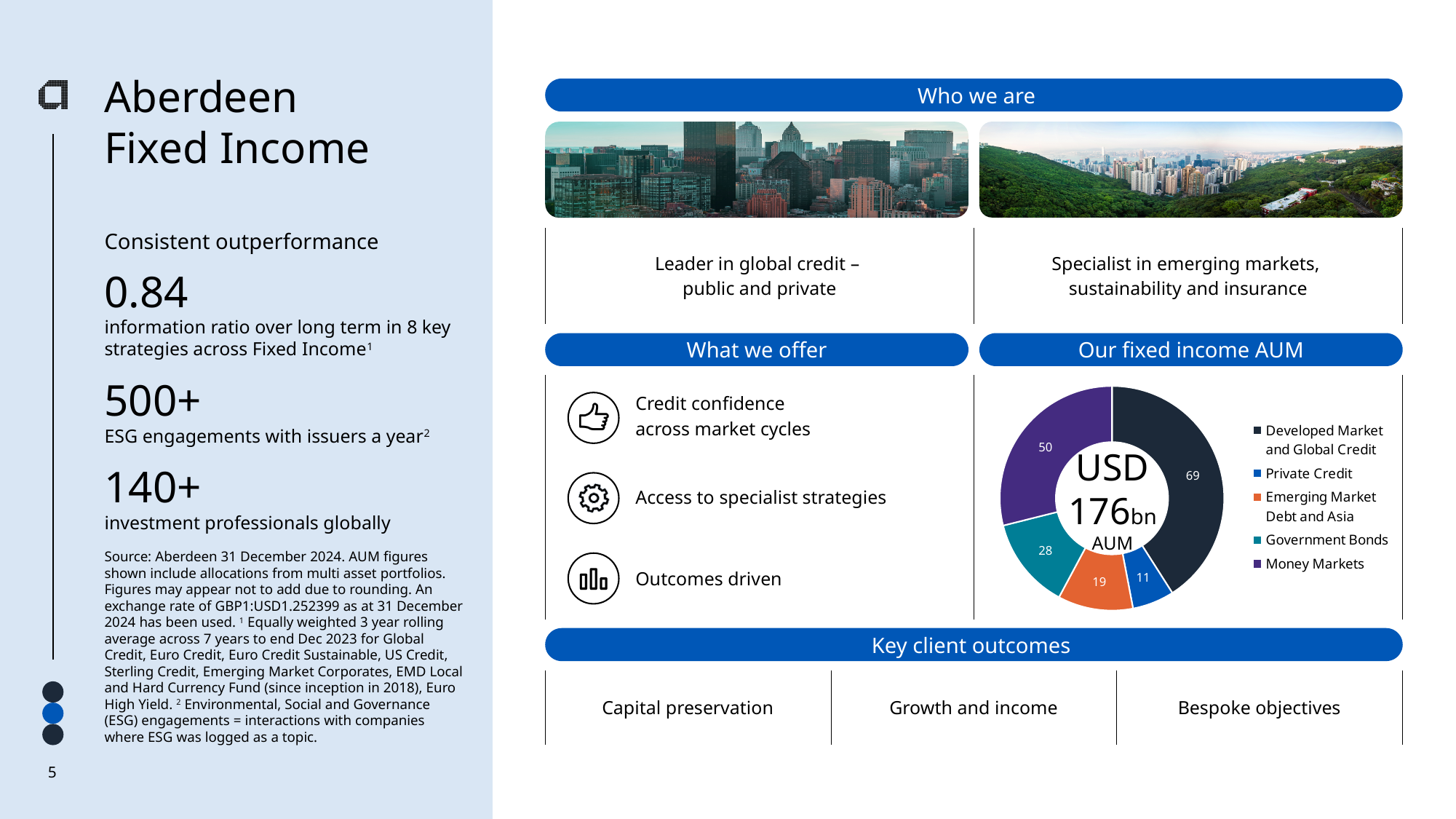
In the "Our fixed income AUM" chart, what is the value for Government Bonds? 28 In the "Our fixed income AUM" chart, which is larger: Government Bonds or Emerging Market Debt and Asia? Government Bonds In the "Our fixed income AUM" chart, what is the value for Money Markets? 50 What type of chart is shown under "Our fixed income AUM"? Pie chart (donut) In the "Our fixed income AUM" chart, what is the value for Emerging Market Debt and Asia? 19 In the "Our fixed income AUM" chart, what is the value for Developed Market and Global Credit? 69 What total AUM figure is shown in the centre of the "Our fixed income AUM" chart? USD 176bn In the "Our fixed income AUM" chart, what is the value for Private Credit? 11 In the "Our fixed income AUM" chart, which category has the largest value? Developed Market and Global Credit How many categories does the legend of the "Our fixed income AUM" chart list? 5 In the "Our fixed income AUM" chart, what is the difference between Developed Market and Global Credit and Money Markets? 19 In the "Our fixed income AUM" chart, which category has the smallest value? Private Credit